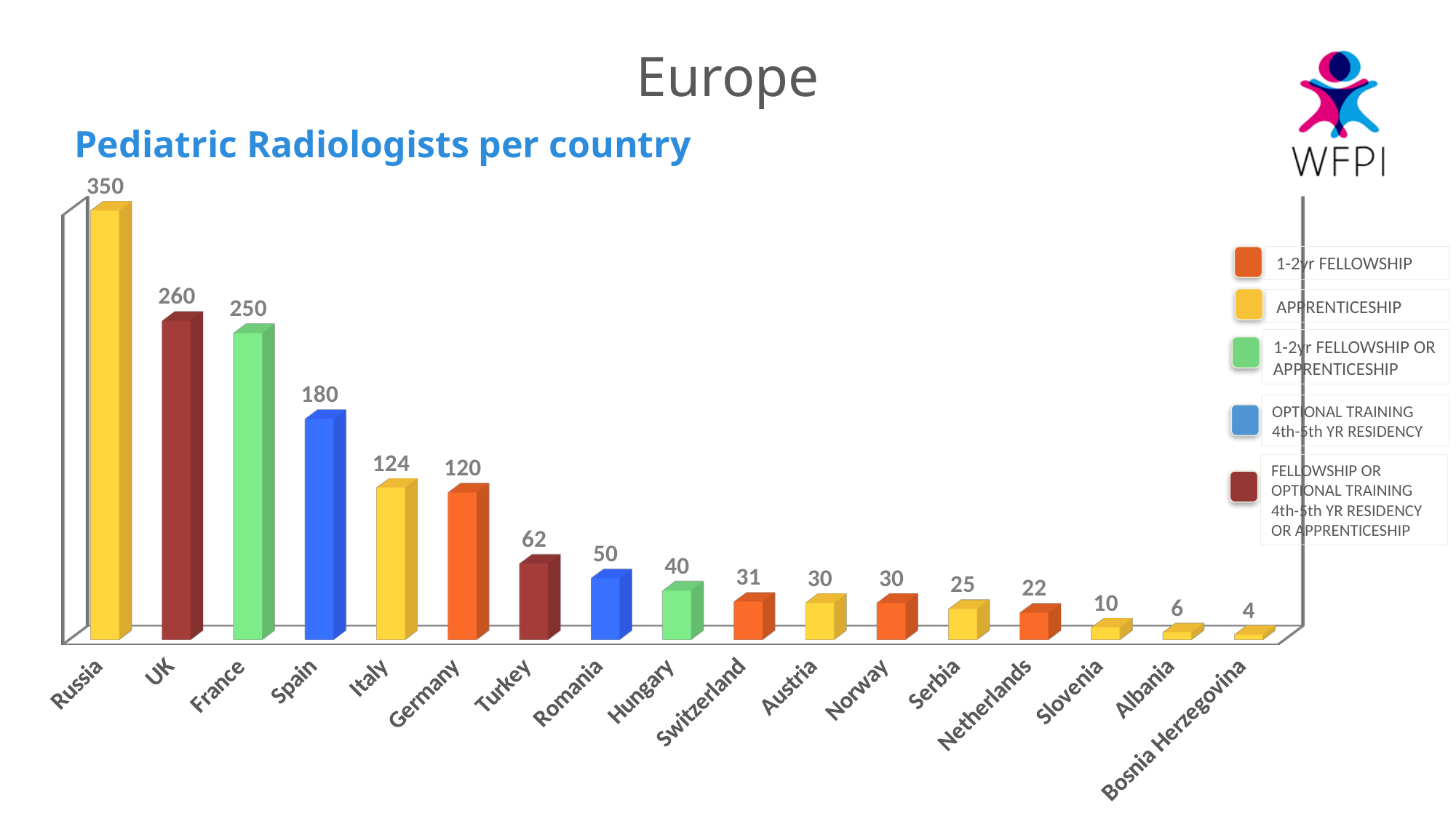
Which is larger, the value for Turkey or the value for Romania? Turkey What is the value for Russia? 350 What is the value for Germany? 120 What is the difference between the values for UK and France? 10 Do the values rise or fall from left to right along the x axis? fall What is the difference between the values for Spain and Italy? 56 How many entries does the legend list? 5 What kind of chart is shown? bar chart What is the value for Netherlands? 22 Which country has the lowest value? Bosnia Herzegovina How many countries are shown on the chart? 17 Which country has the highest value? Russia